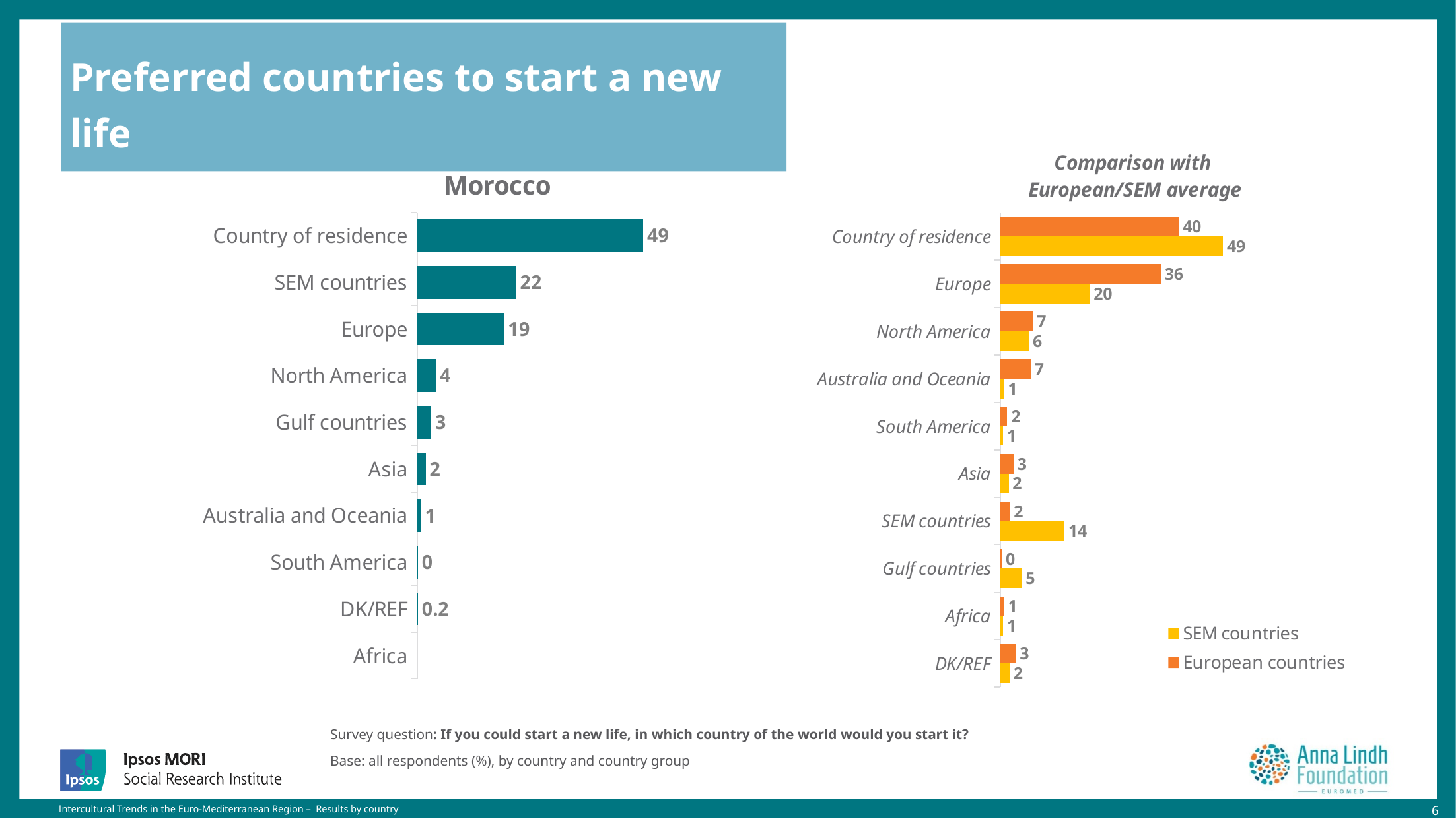
In the Morocco chart, what is the difference between the values for SEM countries and Europe? 3 In the Morocco chart, what is the value for DK/REF? 0.2 How many series does the legend of the Comparison with European/SEM average chart list? 2 In the Comparison with European/SEM average chart, what is the value for SEM countries for the SEM countries series? 14 In the Morocco chart, which category has the highest value? Country of residence In the Comparison with European/SEM average chart, what is the difference between the European countries and SEM countries values for Country of residence? 9 What kind of chart is the Morocco chart? Bar chart In the Morocco chart, how many categories are shown on the axis? 10 In the Comparison with European/SEM average chart, what is the value for Europe for European countries? 36 In the Morocco chart, which is larger, the value for North America or the value for Gulf countries? North America In the Morocco chart, what is the value for SEM countries? 22 In the Morocco chart, what is the value for Country of residence? 49